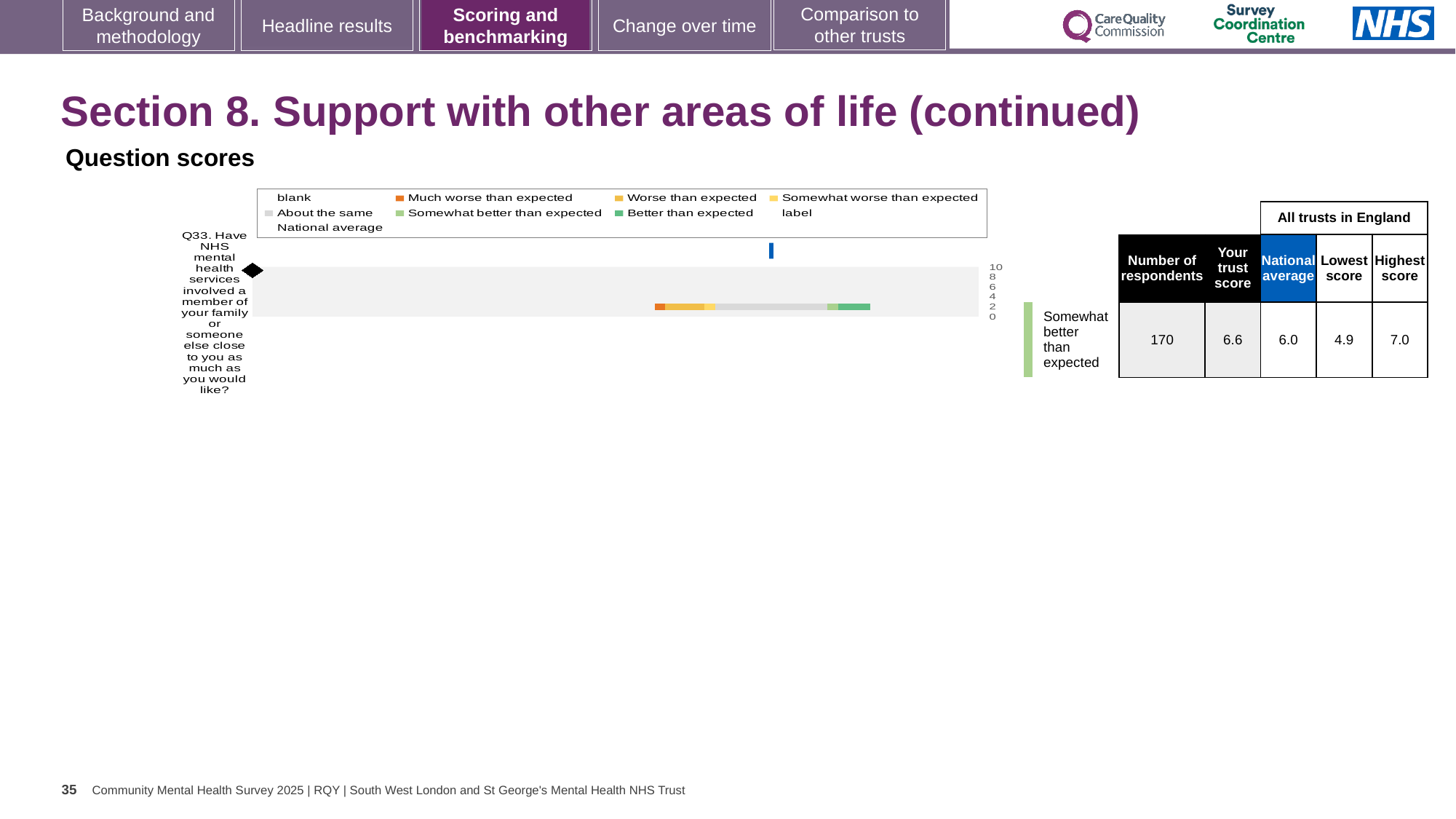
In the table beside the chart, what is the number of respondents for Q33? 170 In the table beside the chart, what is the trust's score for Q33? 6.6 What kind of chart is shown on the slide? bar chart In the table beside the chart, what is the highest score among all trusts in England for Q33? 7.0 Is the trust's score for Q33 higher or lower than the national average? higher What is the highest tick value shown on the chart's axis? 10 In the table beside the chart, what is the national average for Q33? 6.0 What is the difference between the trust's score and the national average for Q33? 0.6 Which question is plotted in the chart? Q33. Have NHS mental health services involved a member of your family or someone else close to you as much as you would like? What rating label is shown to the right of the chart for Q33? Somewhat better than expected How many questions (categories) are plotted in the chart? 1 In the table beside the chart, what is the lowest score among all trusts in England for Q33? 4.9